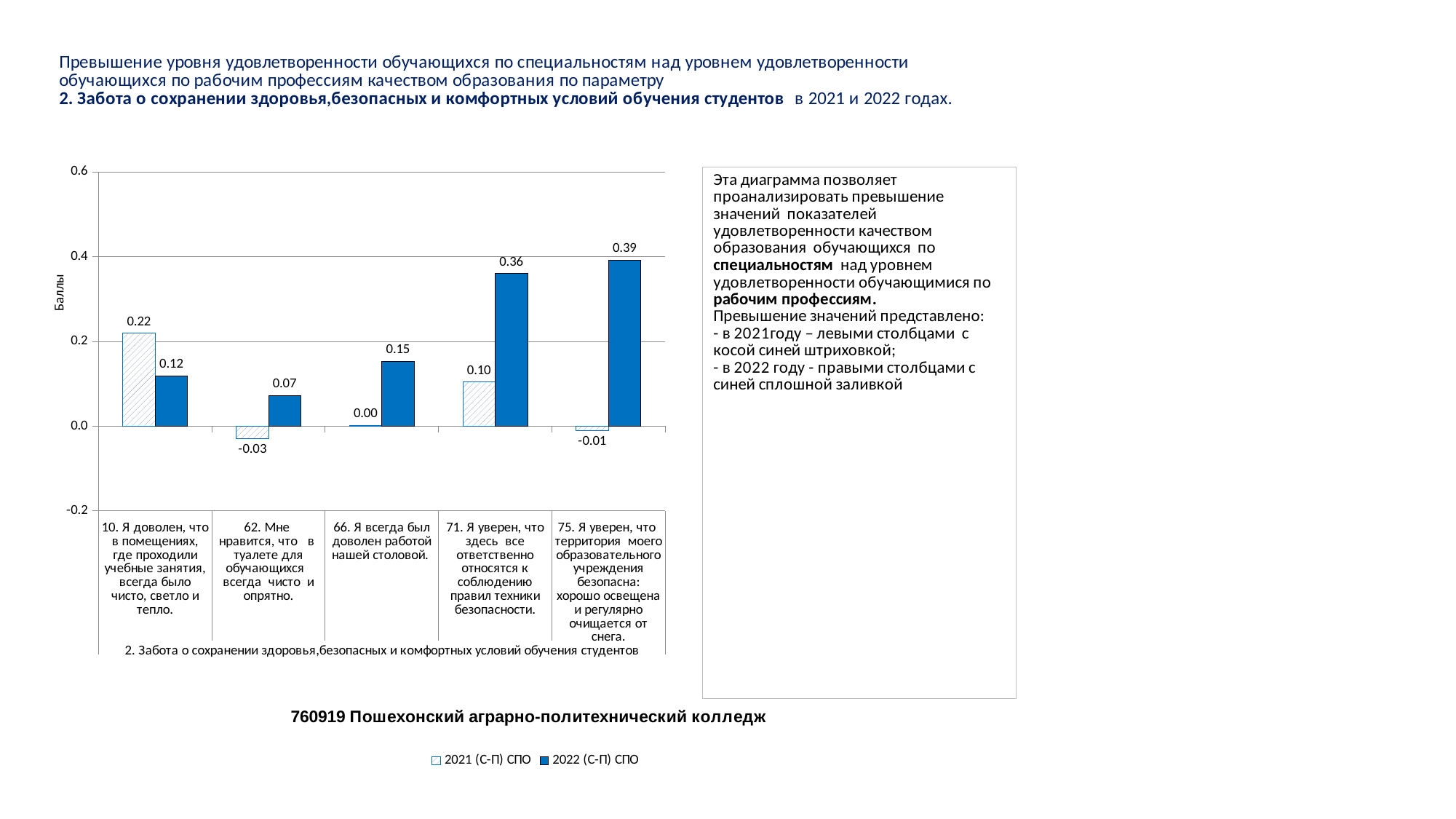
What is the value for 2021 (С-П) СПО for category 62 ("Мне нравится, что в туалете для обучающихся всегда чисто и опрятно")? -0.03 What is the value for 2021 (С-П) СПО for category 10 ("Я доволен, что в помещениях, где проходили учебные занятия, всегда было чисто, светло и тепло")? 0.22 What is the label of the vertical axis of the chart? Баллы What is the value for 2022 (С-П) СПО for category 66 ("Я всегда был доволен работой нашей столовой")? 0.15 Which category has the highest value for the 2022 (С-П) СПО series? 75. Я уверен, что территория моего образовательного учреждения безопасна: хорошо освещена и регулярно очищается от снега. What is the value for 2022 (С-П) СПО for category 71 ("Я уверен, что здесь все ответственно относятся к соблюдению правил техники безопасности")? 0.36 For category 10, which series has the larger value, 2021 (С-П) СПО or 2022 (С-П) СПО? 2021 (С-П) СПО What is the difference between the 2022 and 2021 values for category 71? 0.26 How many categories are shown on the x axis of the chart? 5 What type of chart is shown on the slide? Bar chart How many series does the chart legend list? 2 Which category has the lowest value for the 2021 (С-П) СПО series? 62. Мне нравится, что в туалете для обучающихся всегда чисто и опрятно.